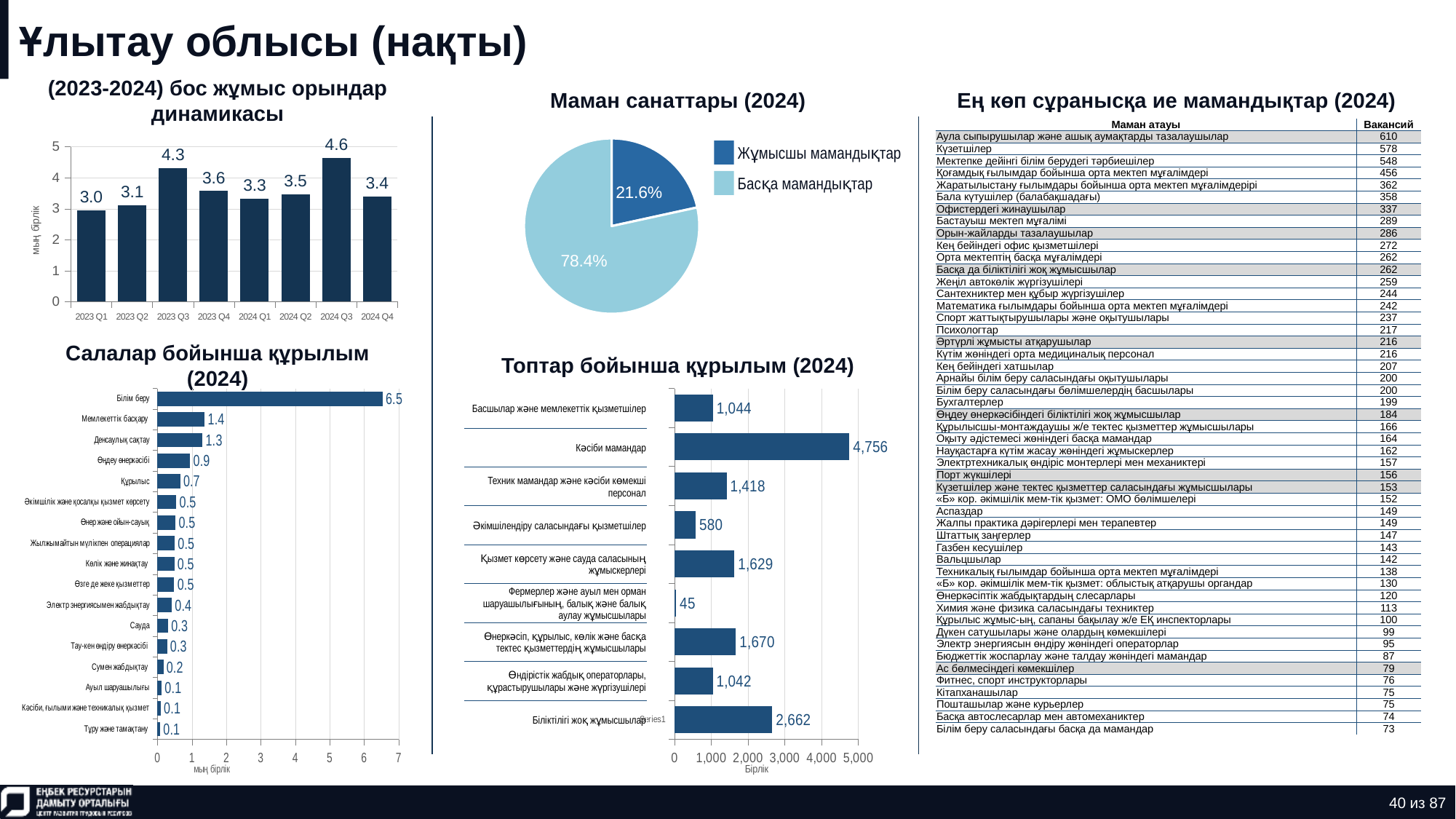
In the pie chart 'Маман санаттары (2024)', what share does 'Жұмысшы мамандықтар' have? 21.6% In the chart '(2023-2024) бос жұмыс орындар динамикасы', how many quarters are plotted? 8 In the chart '(2023-2024) бос жұмыс орындар динамикасы', what is the value for 2024 Q3? 4.6 In the chart 'Топтар бойынша құрылым (2024)', how many categories are plotted? 9 In the chart 'Топтар бойынша құрылым (2024)', what is the value for 'Біліктілігі жоқ жұмысшылар'? 2,662 What kind of chart is 'Маман санаттары (2024)'? Pie chart In the chart '(2023-2024) бос жұмыс орындар динамикасы', which quarter has the lowest value? 2023 Q1 In the chart 'Салалар бойынша құрылым (2024)', what is the value for 'Білім беру'? 6.5 How many entries does the legend of the chart 'Маман санаттары (2024)' list? 2 In the chart 'Салалар бойынша құрылым (2024)', which is larger: 'Мемлекеттік басқару' or 'Өңдеу өнеркәсібі'? Мемлекеттік басқару In the chart 'Топтар бойынша құрылым (2024)', which category has the highest value? Кәсіби мамандар In the chart '(2023-2024) бос жұмыс орындар динамикасы', what is the difference between 2023 Q3 and 2023 Q4? 0.7